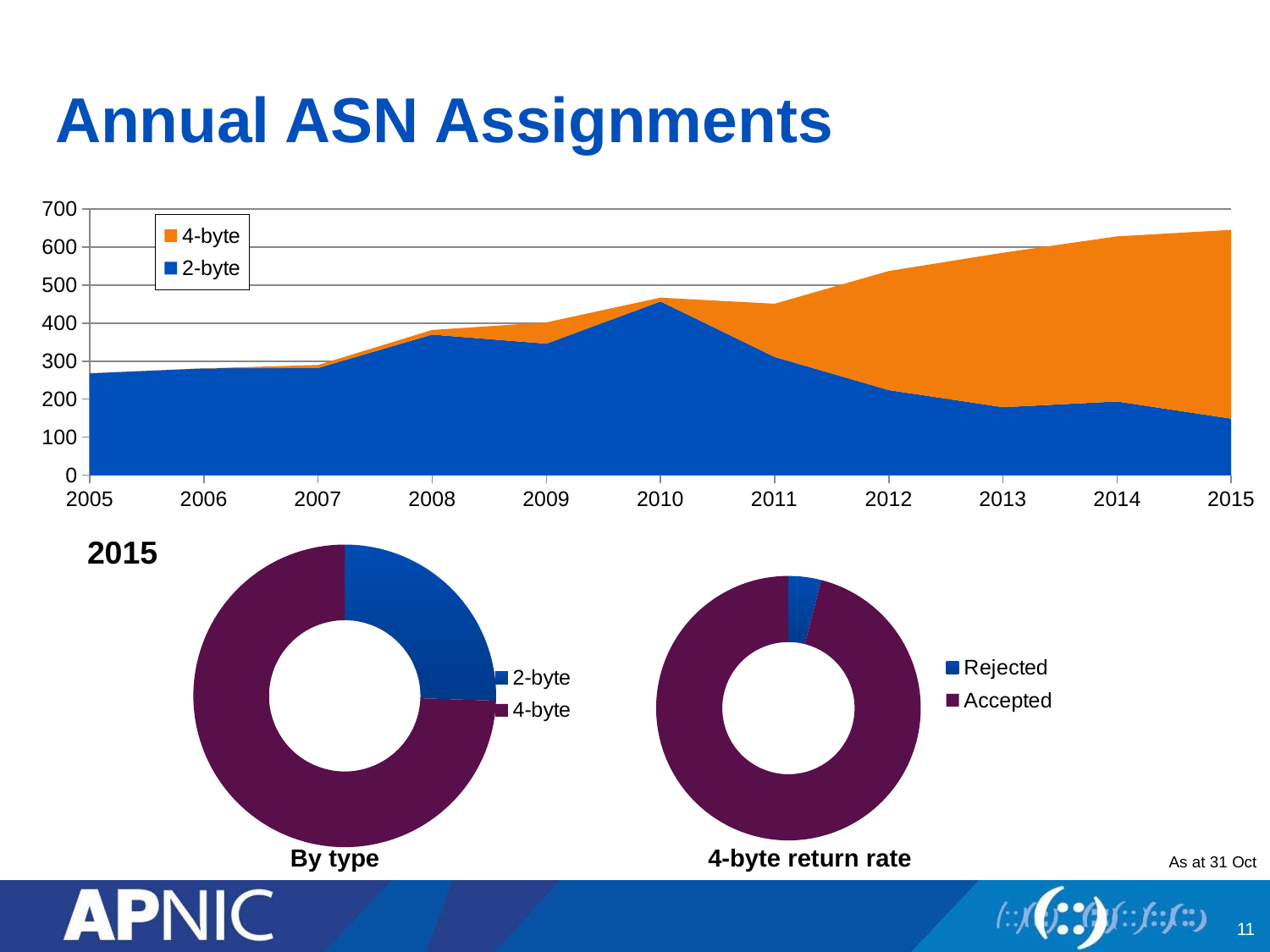
In the top 'Annual ASN Assignments' chart, which series is larger in 2005, 2-byte or 4-byte? 2-byte In the top 'Annual ASN Assignments' chart, how many years are shown on the x axis? 11 What kind of chart is the top chart titled 'Annual ASN Assignments'? area chart In the top 'Annual ASN Assignments' chart, which series is larger in 2015, 2-byte or 4-byte? 4-byte In the top 'Annual ASN Assignments' chart, how many series does the legend list? 2 In the top 'Annual ASN Assignments' chart, is the total stacked value for 2015 greater or less than 600? greater In the bottom-left 'By type' donut chart for 2015, which slice is larger, 2-byte or 4-byte? 4-byte In the top 'Annual ASN Assignments' chart, which series is shown in orange? 4-byte In the top 'Annual ASN Assignments' chart, does the total number of assignments rise or fall from 2005 to 2015? rise In the top 'Annual ASN Assignments' chart, is the 2-byte value for 2015 greater or less than 200? less In the top 'Annual ASN Assignments' chart, is the 2-byte value for 2010 greater or less than 400? greater